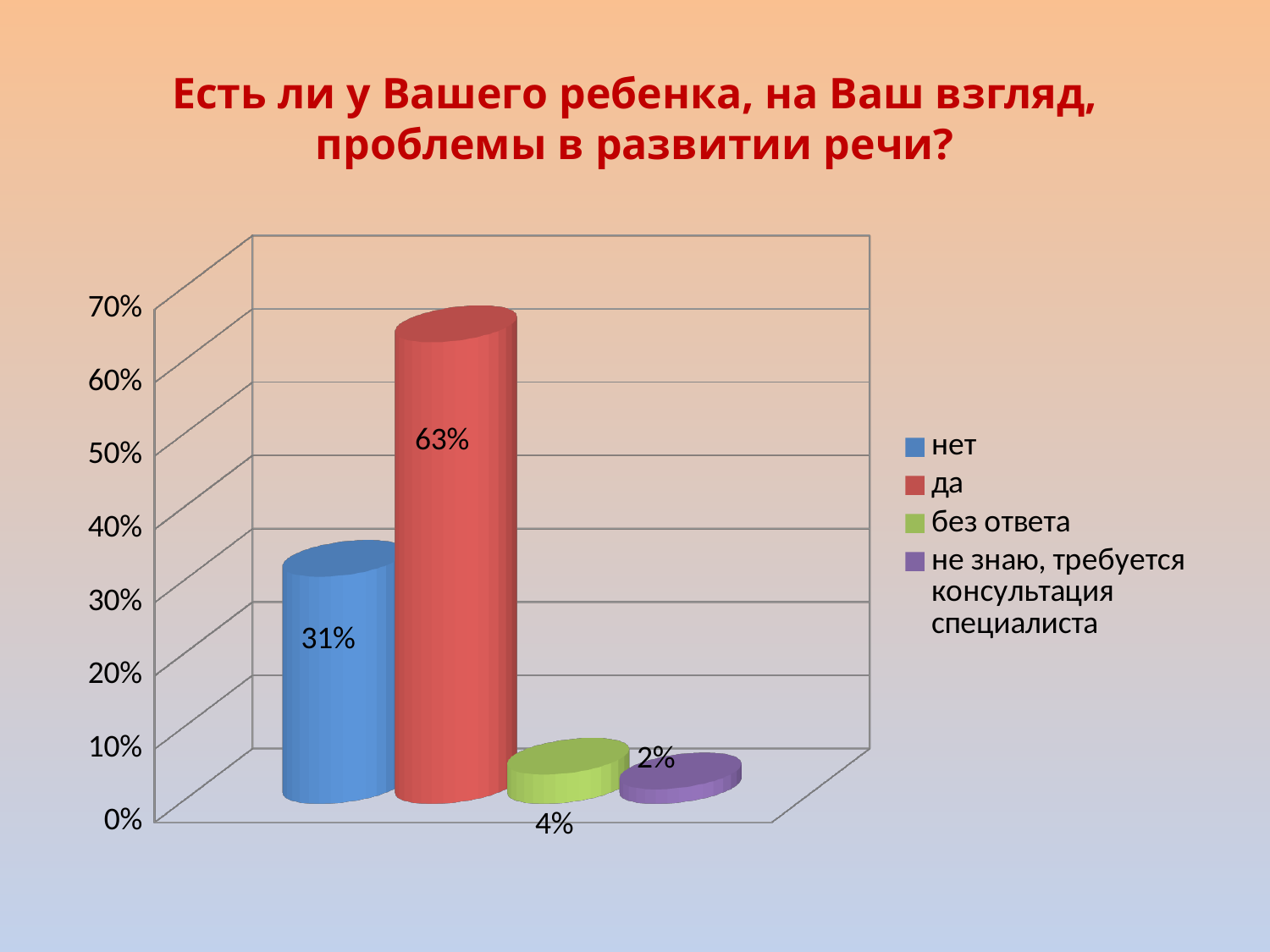
Which is larger, the value for "нет" or the value for "без ответа"? нет What is the value for "без ответа"? 4% What kind of chart is shown on the slide? bar chart What is the difference between the values for "да" and "нет"? 32% Which answer option has the highest value? да How many answer options are shown in the chart? 4 Is the value for "да" greater or less than 60%? greater Which answer option has the lowest value? не знаю, требуется консультация специалиста What colour is the bar for "да"? red What percentage of respondents answered "нет"? 31% What is the value for "не знаю, требуется консультация специалиста"? 2% What percentage of respondents answered "да"? 63%